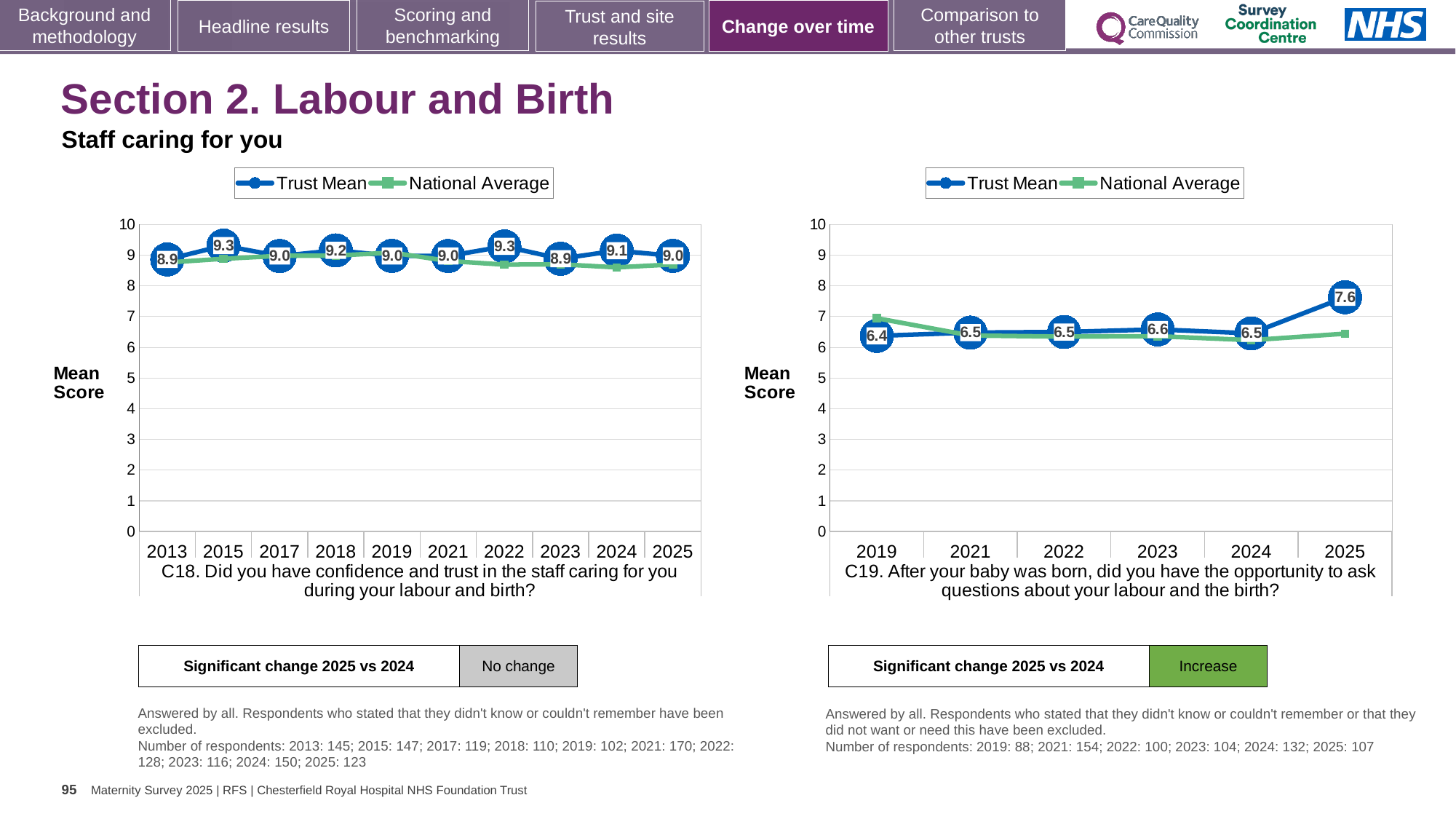
In the C19 chart on the right, which year has the highest Trust Mean? 2025 What type of chart is the C18 chart on the left? line chart In the C19 chart on the right, which year has the lowest Trust Mean? 2019 In the C18 chart on the left, what is the difference between the Trust Mean for 2018 and for 2013? 0.3 In the C19 chart on the right, what is the Trust Mean for 2025? 7.6 In the C18 chart on the left, what is the Trust Mean for 2025? 9.0 In the C18 chart on the left, is the Trust Mean for 2022 larger or smaller than the Trust Mean for 2023? larger In the C19 chart on the right, what is the difference between the Trust Mean for 2025 and for 2024? 1.1 How many years are plotted in the C18 chart on the left? 10 In the C18 chart on the left, what is the Trust Mean for 2015? 9.3 In the C19 chart on the right, is the National Average for 2025 greater or less than 7? less How many series does the legend of the C19 chart on the right list? 2